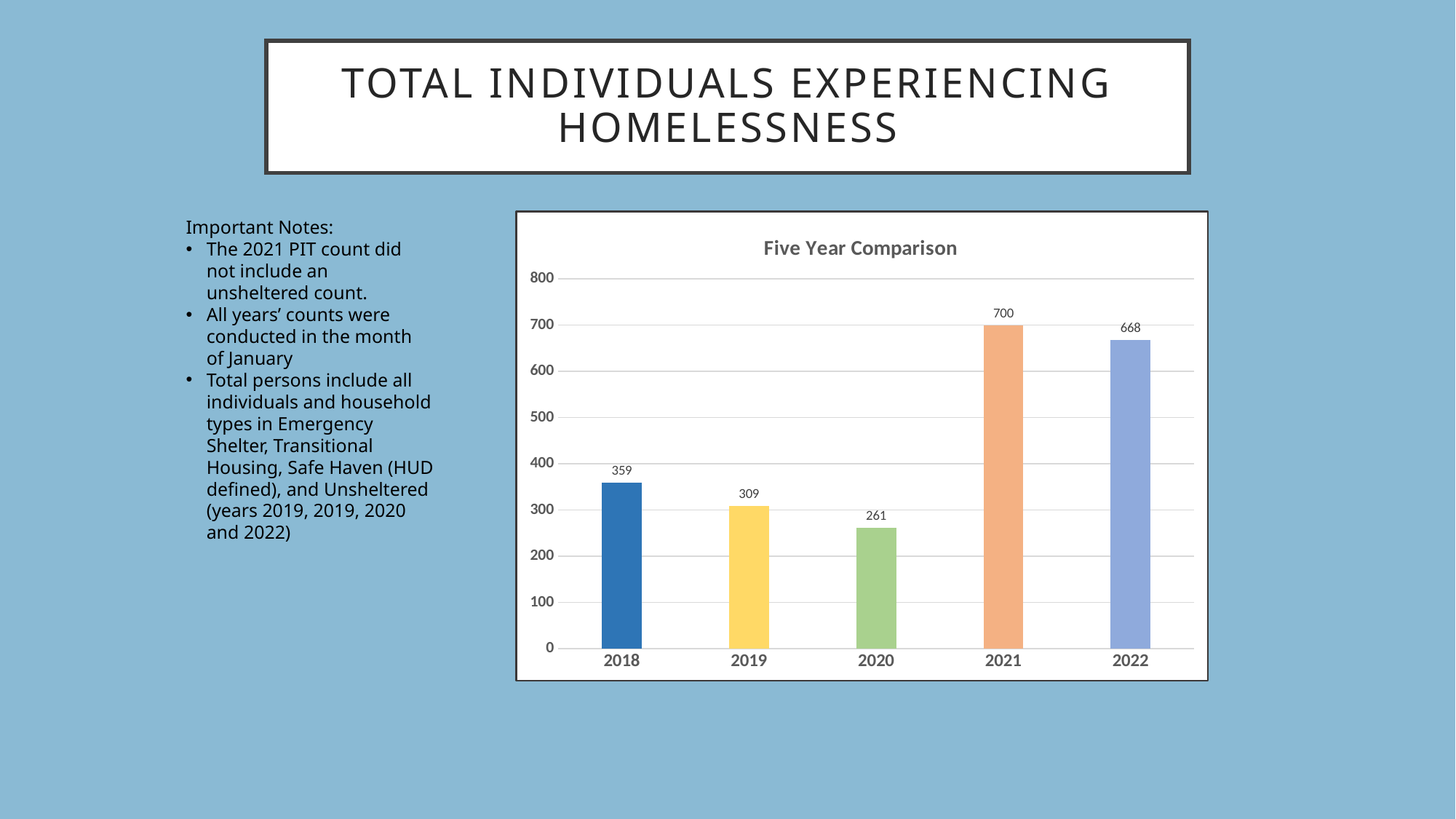
What is the value for 2020? 261 What is the difference between the values for 2018 and 2019? 50 What kind of chart is shown on the slide? bar chart What is the title of the chart? Five Year Comparison What is the value for 2018? 359 What is the value for 2022? 668 Which year has the highest value? 2021 What is the difference between the values for 2021 and 2022? 32 How many years are shown on the chart? 5 Is the value for 2021 greater or less than 600? greater Which year has the lowest value? 2020 Which is larger, the value for 2019 or the value for 2020? 2019